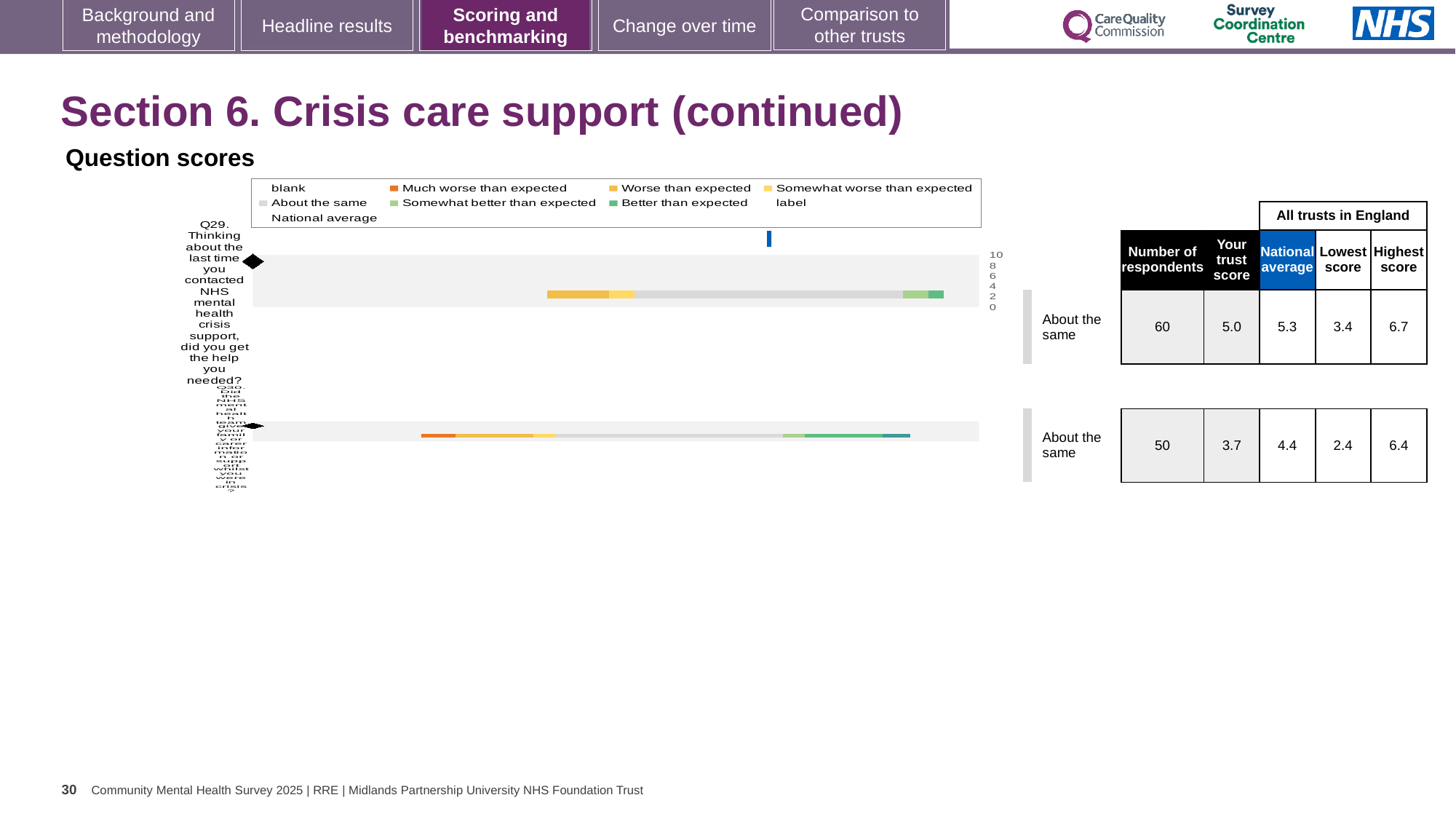
How many respondents answered Q30? 50 What benchmark category label is shown next to the Q29 bar? About the same What is the lowest score among all trusts in England for Q30? 2.4 What is the highest score among all trusts in England for Q29? 6.7 How many questions (rows) are plotted in the chart? 2 What is 'Your trust score' for Q30? 3.7 What kind of chart is shown under 'Question scores'? bar chart What is the difference between the national average and the trust score for Q30? 0.7 For Q29, which is larger: the trust score or the national average? national average What is 'Your trust score' for Q29? 5.0 What is the national average for Q29? 5.3 Which question has the higher trust score, Q29 or Q30? Q29